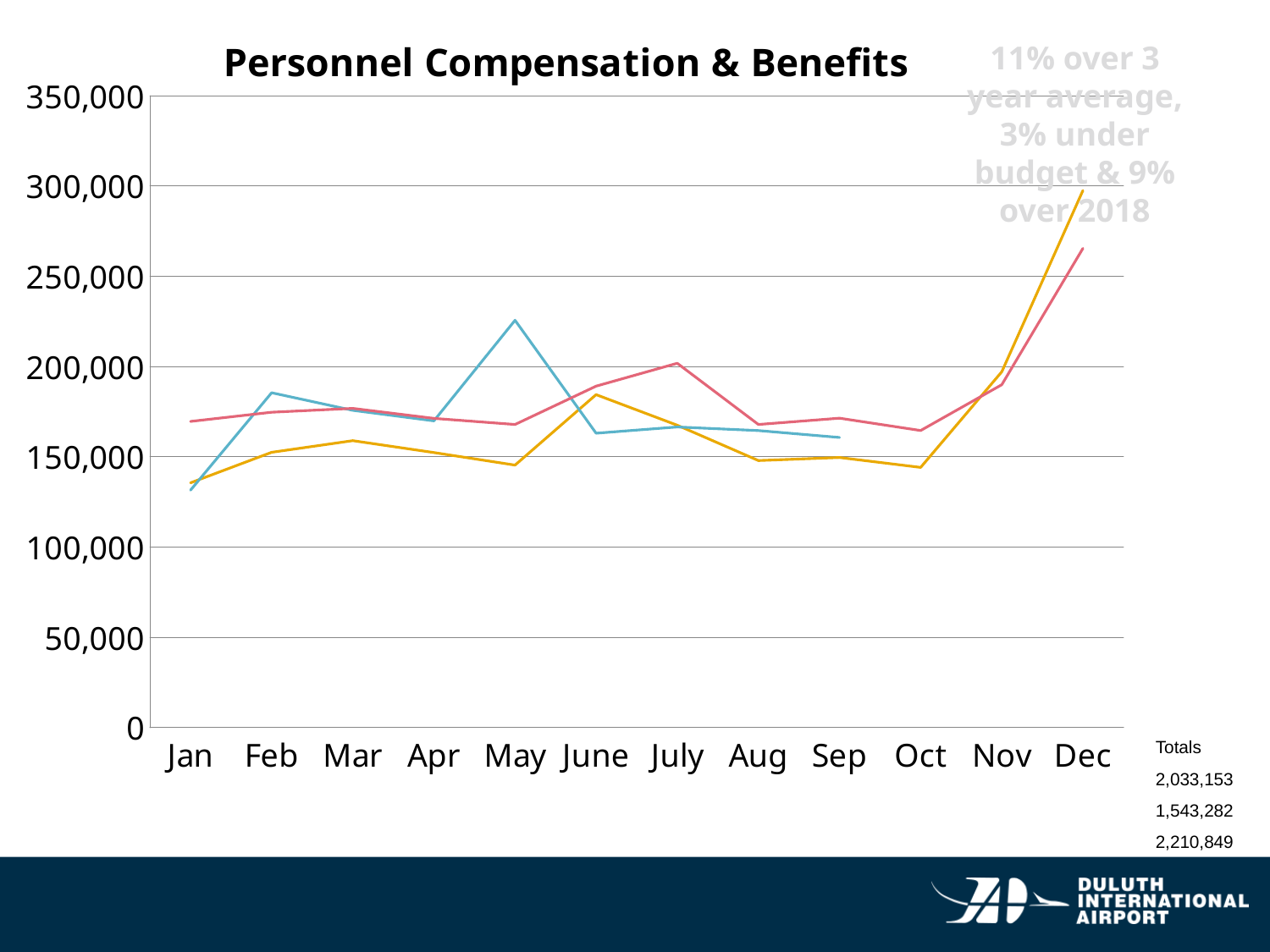
In which month does the blue line reach its highest value? May Is the value of the blue line in Jan greater or less than 150,000? less In which month is the blue line at its lowest value? Jan In which month does the yellow line reach its highest value? Dec Is the value of the yellow line in Dec greater or less than 250,000? greater How many months are shown along the x axis of the chart? 12 In May, which line has the higher value, the blue line or the pink line? blue line How many lines are plotted on the chart? 3 What is the title of the chart? Personnel Compensation & Benefits What kind of chart is shown on the slide? line chart Does the yellow line rise or fall from Oct to Dec? rise Is the value of the blue line in May greater or less than 200,000? greater